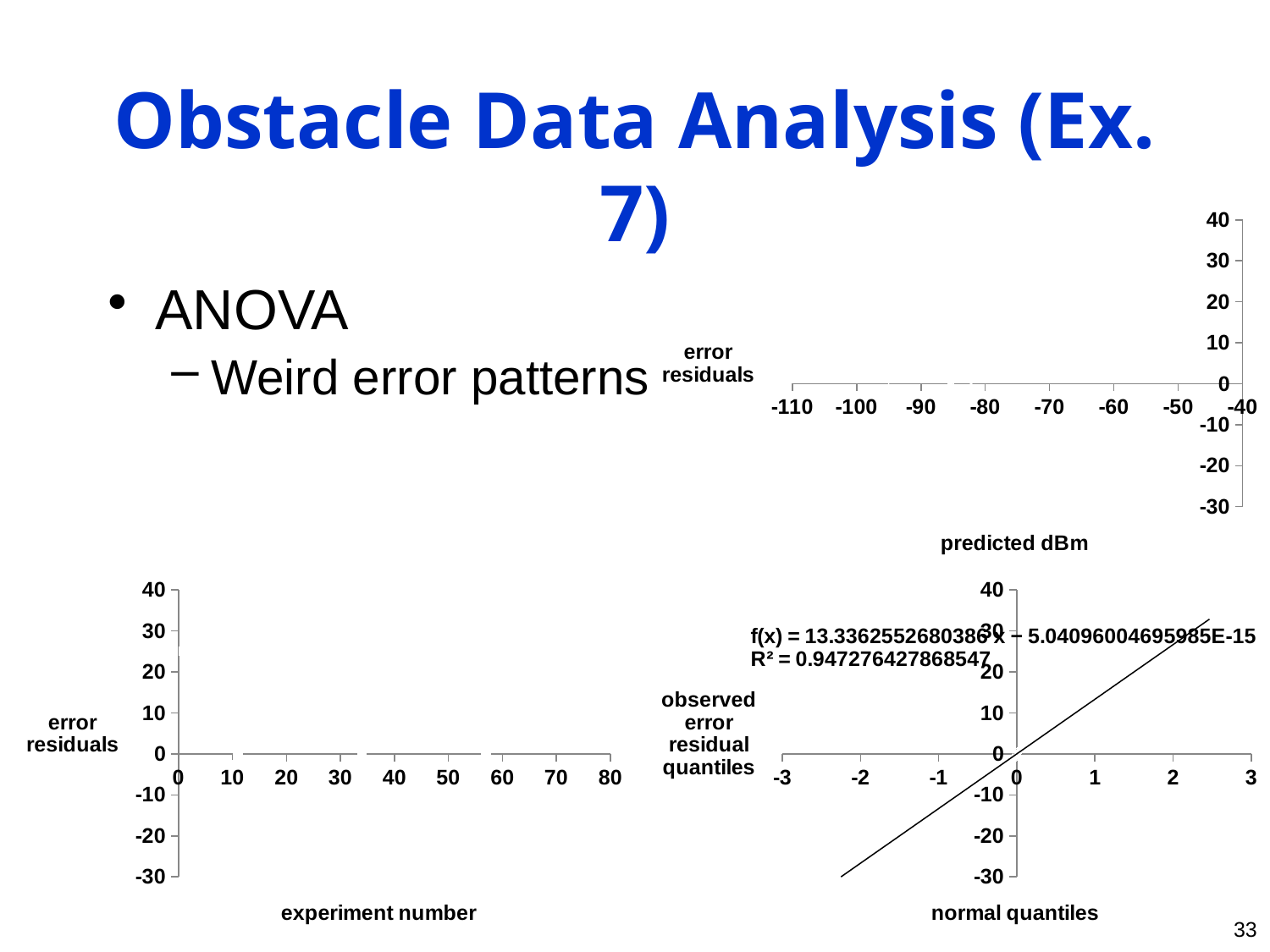
What is the y-axis label of the bottom-left chart? error residuals What is the x-axis label of the bottom-right chart? normal quantiles On the bottom-right chart, is the R² value greater or less than 0.9? greater On the bottom-right chart (normal quantiles), what is the slope of the fitted line f(x) printed on the chart? 13.3362552680386 How many charts are shown on the slide? 3 What is the x-axis label of the top-right chart? predicted dBm On the bottom-right chart (normal quantiles), what is the R² value printed on the chart? 0.947276427868547 On the bottom-right chart (normal quantiles), does the fitted line rise or fall as the x axis increases? rise